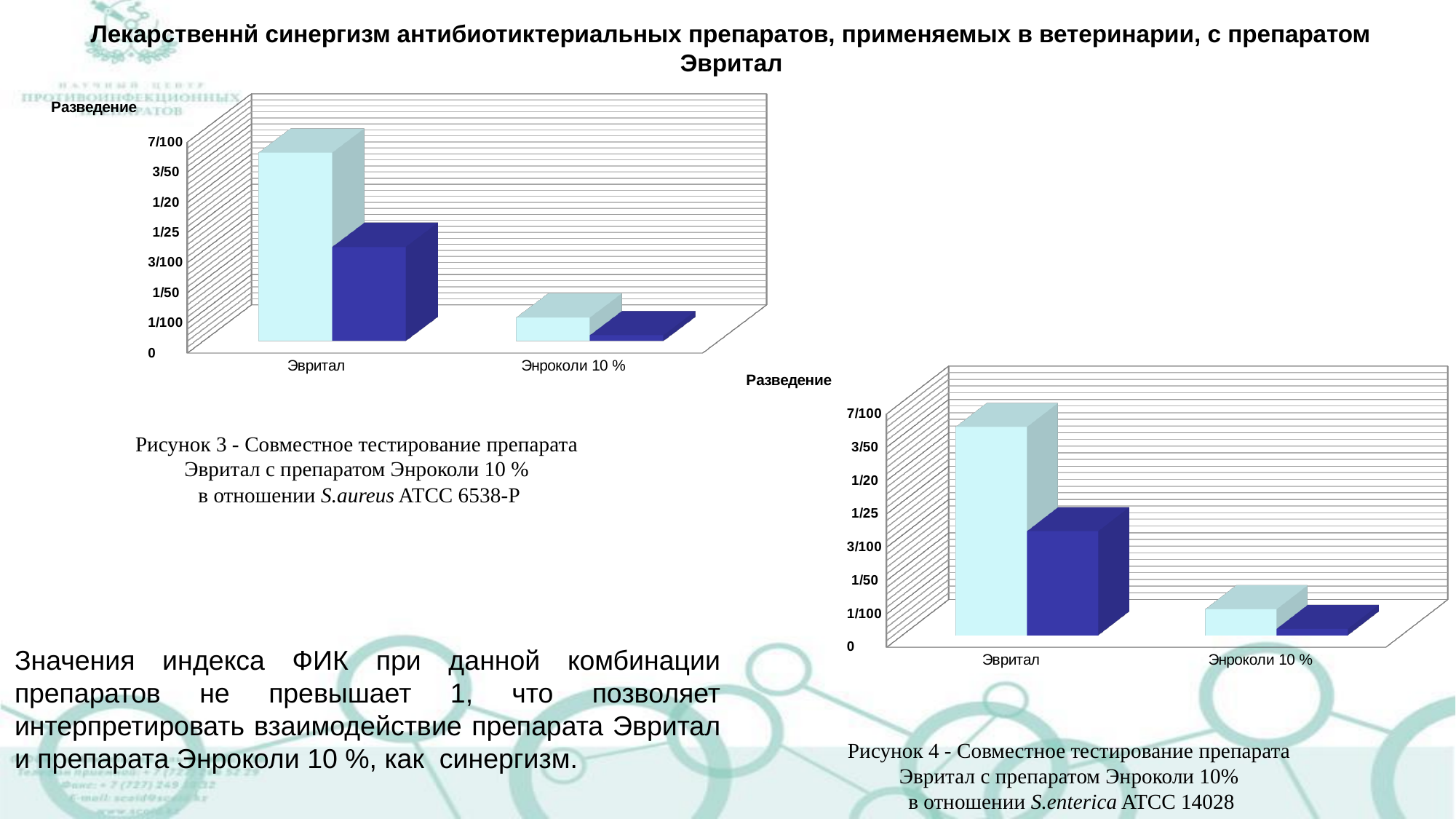
In Рисунок 4 (the lower-right chart), which category has the shortest bars? Энроколи 10 % In Рисунок 3 (the upper-left chart), how many categories are shown on the x axis? 2 In Рисунок 4 (the lower-right chart), for the category Эвритал, which bar is taller: the light blue bar or the dark blue bar? The light blue bar In Рисунок 3 (the upper-left chart), which category has the tallest bars? Эвритал In Рисунок 4 (the lower-right chart), which category has the tallest bars? Эвритал In Рисунок 3 (the upper-left chart), which category has the shortest bars? Энроколи 10 % In Рисунок 3 (the upper-left chart), for the category Эвритал, which bar is taller: the light blue bar or the dark blue bar? The light blue bar What is the title of the vertical axis in Рисунок 3 (the upper-left chart)? Разведение Which bacterial strain is named in the caption of Рисунок 4 (the lower-right chart)? S.enterica ATCC 14028 What kind of chart is shown in Рисунок 3 (the upper-left chart)? Bar chart In Рисунок 4 (the lower-right chart), how many categories are shown on the x axis? 2 What kind of chart is shown in Рисунок 4 (the lower-right chart)? Bar chart